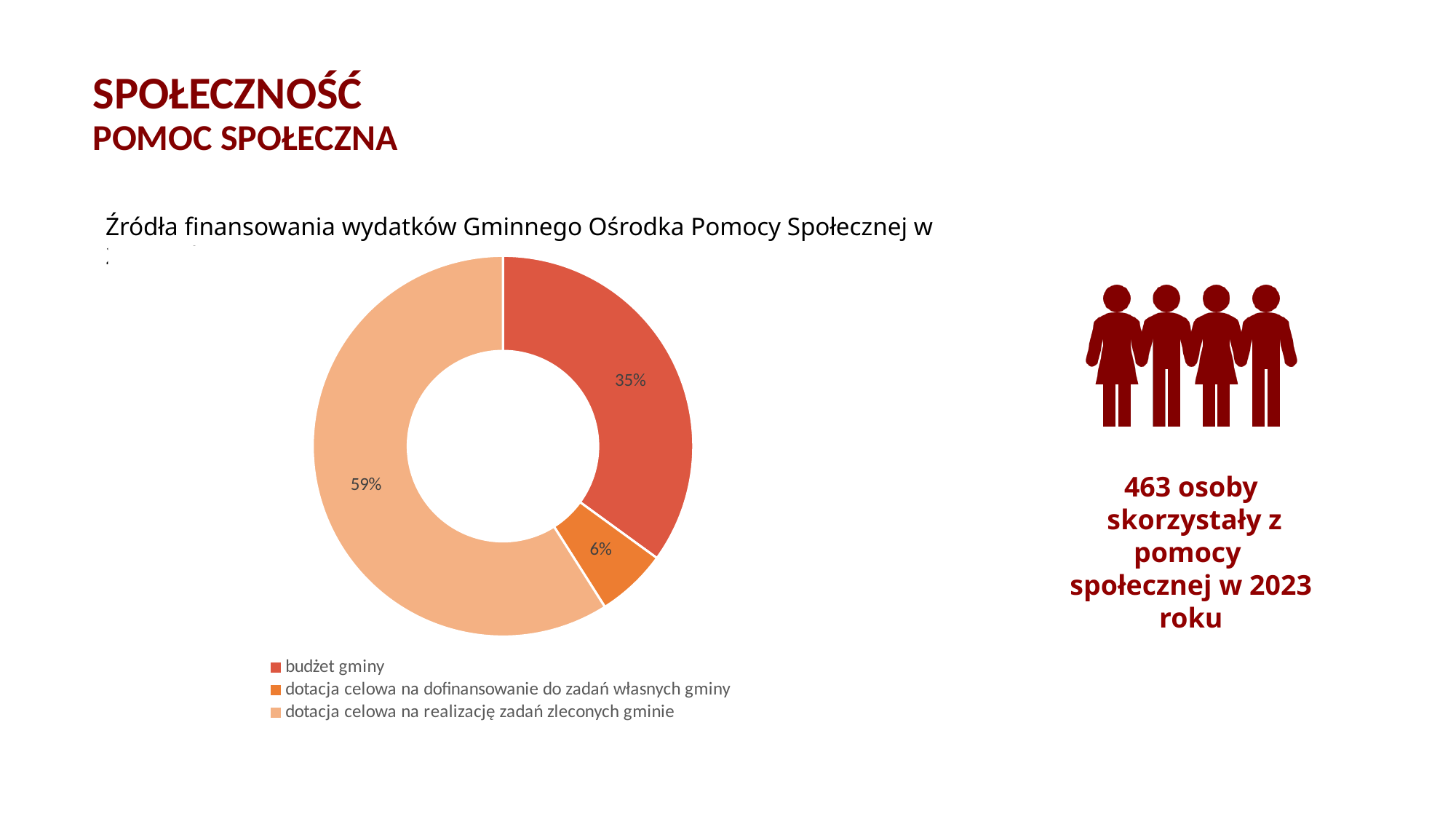
Which funding source has the smallest share in the chart? dotacja celowa na dofinansowanie do zadań własnych gminy What share of the doughnut chart does 'dotacja celowa na dofinansowanie do zadań własnych gminy' represent? 6% What type of chart is shown on the slide? doughnut chart What is the difference in percentage points between the share for 'budżet gminy' and the share for 'dotacja celowa na dofinansowanie do zadań własnych gminy'? 29 percentage points What is the difference in percentage points between the share for 'dotacja celowa na realizację zadań zleconych gminie' and the share for 'budżet gminy'? 24 percentage points How many entries does the chart legend list? 3 What share of the doughnut chart does 'budżet gminy' represent? 35% Which funding source has the largest share in the chart? dotacja celowa na realizację zadań zleconych gminie What share of the doughnut chart does 'dotacja celowa na realizację zadań zleconych gminie' represent? 59% Which is larger: the share for 'budżet gminy' or the share for 'dotacja celowa na realizację zadań zleconych gminie'? dotacja celowa na realizację zadań zleconych gminie Which legend entry is shown in the darkest red colour? budżet gminy How many categories (slices) does the chart show? 3